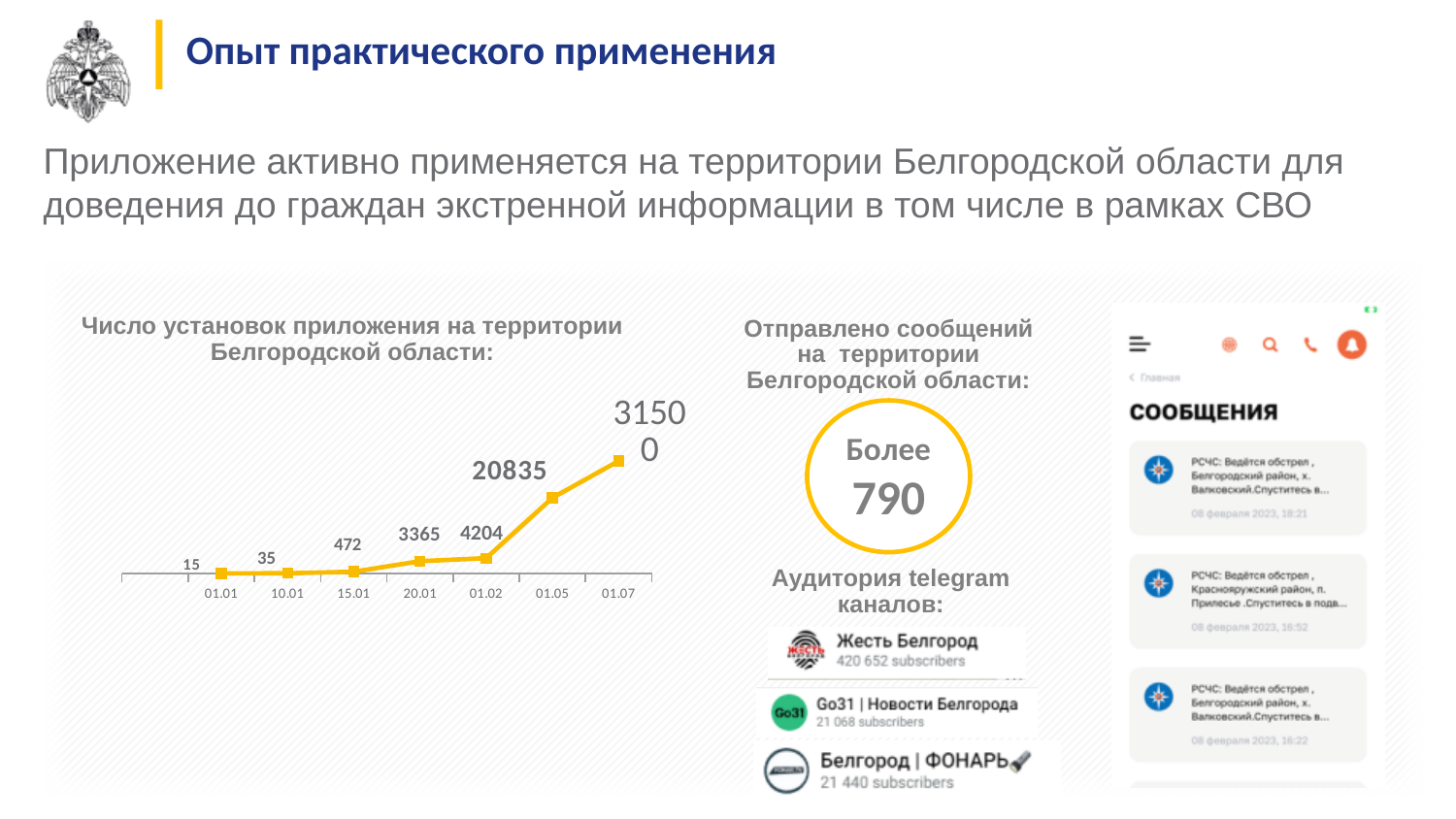
What kind of chart is used to show the number of app installations in the Belgorod region? line chart On the app installations chart, what is the value for 01.05? 20835 How many data points are plotted on the app installations chart? 7 On the app installations chart, what is the difference between the values for 10.01 and 01.01? 20 On the app installations chart, what is the value for 20.01? 3365 On the app installations chart, what is the value for 01.01? 15 On the app installations chart, what is the difference between the values for 01.02 and 20.01? 839 On the app installations chart, which is larger: the value for 01.05 or the value for 01.02? 01.05 On the app installations chart, which date has the highest value? 01.07 On the app installations chart, what is the value for 15.01? 472 On the app installations chart, do the values rise or fall along the x axis? rise On the app installations chart, which date has the lowest value? 01.01